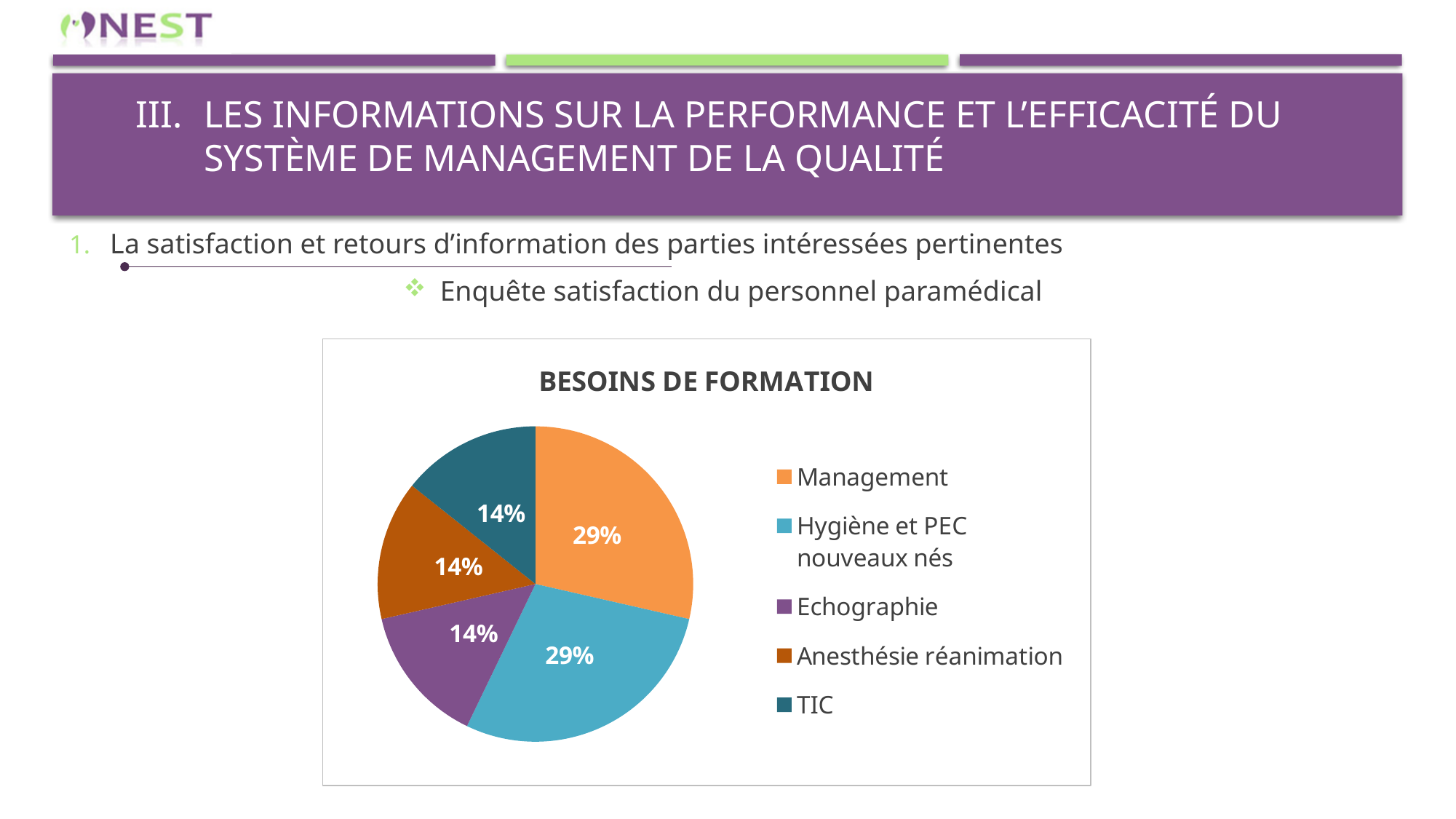
What is the difference between the share for Hygiène et PEC nouveaux nés and the share for Echographie? 15% Which colour represents Anesthésie réanimation in the pie chart? dark orange (brown) What kind of chart is shown on the slide? pie chart What share of the pie does Echographie represent? 14% What share of the pie does TIC represent? 14% What share of the pie does Management represent? 29% Which is larger, the share for Management or the share for TIC? Management How many categories does the pie chart have? 5 What share of the pie does Hygiène et PEC nouveaux nés represent? 29% What share of the pie does Anesthésie réanimation represent? 14% What is the title of the chart? BESOINS DE FORMATION Which is larger, the share for Hygiène et PEC nouveaux nés or the share for Anesthésie réanimation? Hygiène et PEC nouveaux nés